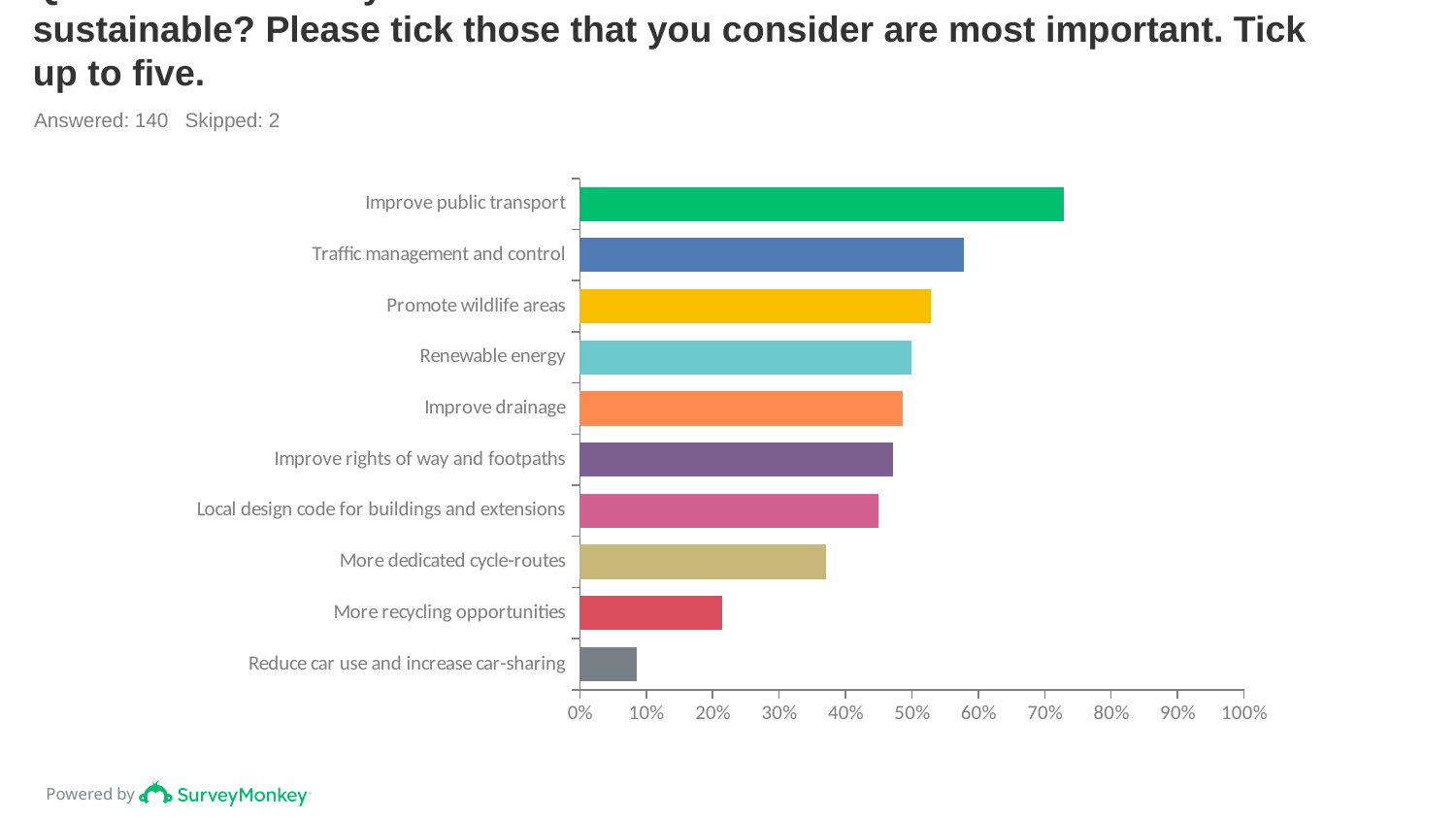
Is the value for Traffic management and control greater or less than 50%? greater Which category has the lowest value? Reduce car use and increase car-sharing Is the value for Improve public transport greater or less than 60%? greater How many respondents answered the question according to the slide? 140 What kind of chart is shown on the slide? bar chart Is the value for Reduce car use and increase car-sharing greater or less than 20%? less How many categories are plotted in the chart? 10 Which category has the highest value? Improve public transport Which is larger, the value for Improve public transport or the value for More recycling opportunities? Improve public transport Which is larger, the value for More dedicated cycle-routes or the value for Traffic management and control? Traffic management and control